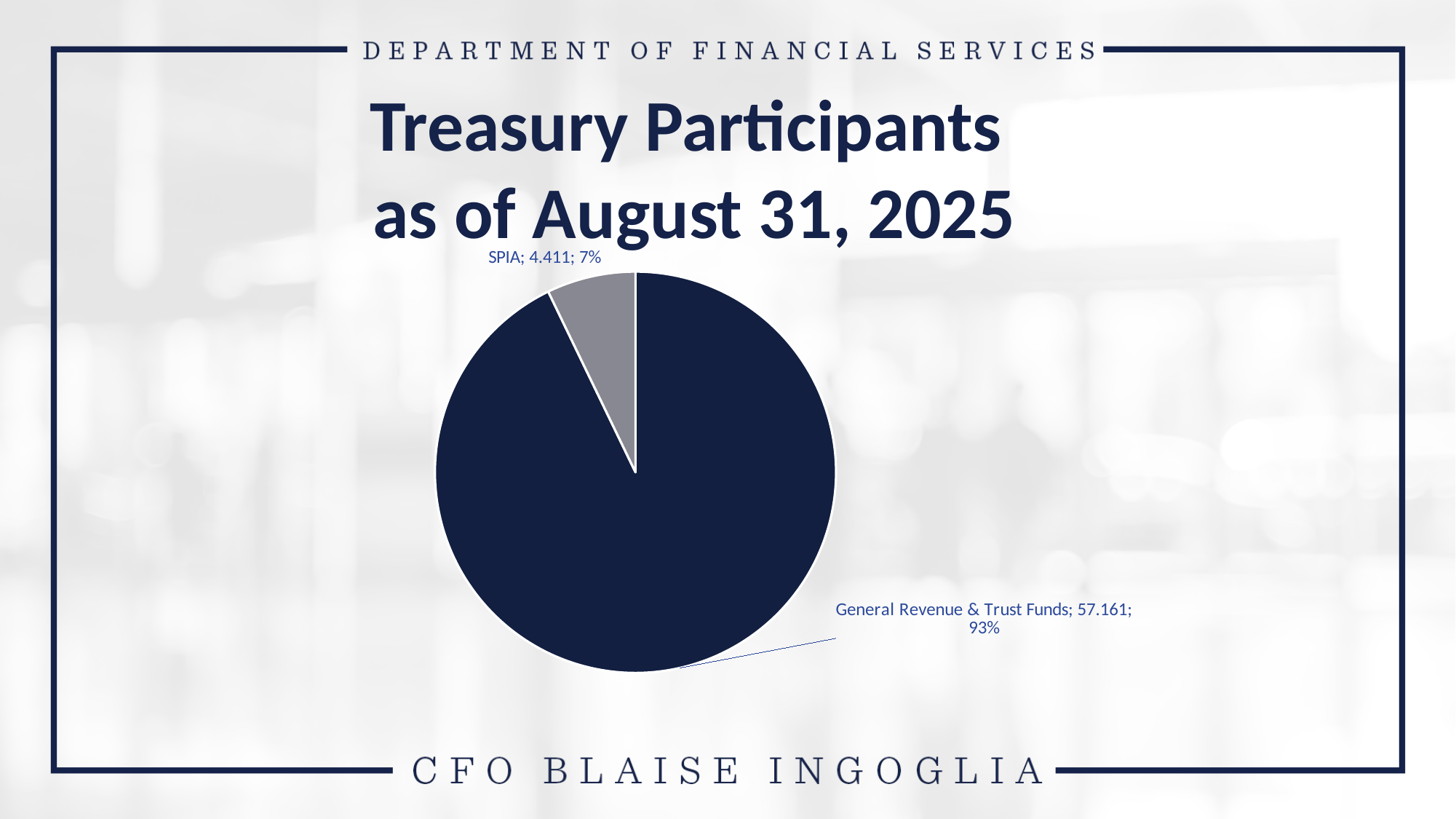
Which is larger, the value for SPIA or the value for General Revenue & Trust Funds? General Revenue & Trust Funds What share of the pie does SPIA represent? 7% Which category has the largest slice? General Revenue & Trust Funds Which category has the smallest slice? SPIA What is the title of the chart? Treasury Participants as of August 31, 2025 What colour is the SPIA slice? Gray What is the value for SPIA? 4.411 How many slices does the pie chart have? 2 What kind of chart is shown on the slide? Pie chart What share of the pie does General Revenue & Trust Funds represent? 93% What is the difference between the values for General Revenue & Trust Funds and SPIA? 52.750 What is the value for General Revenue & Trust Funds? 57.161